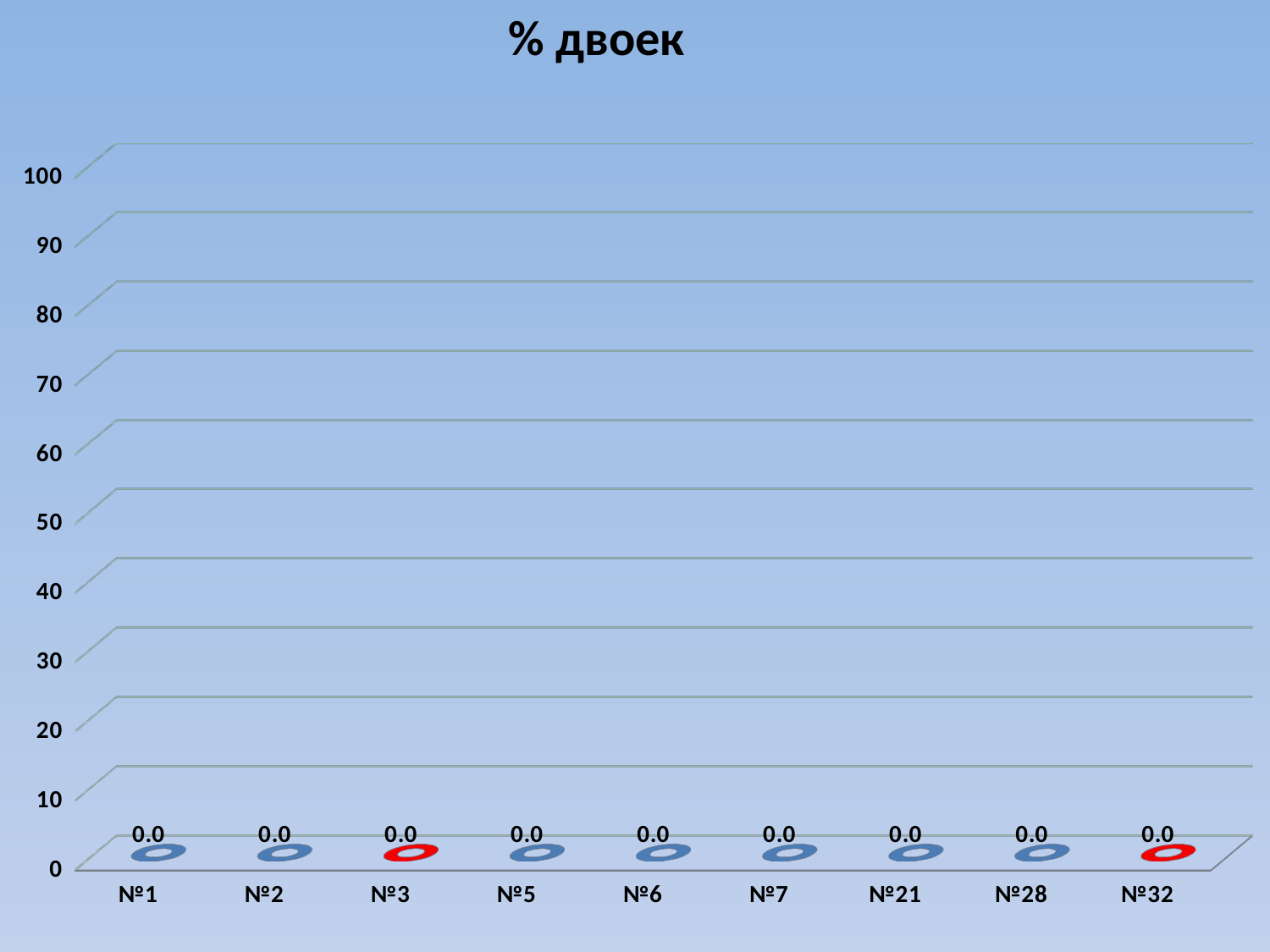
What type of chart is shown on the slide? bar chart Which categories are shown in red rather than blue? №3 and №32 How many categories are shown on the x axis of the chart? 9 What is the value for №32? 0.0 What is the difference between the values for №2 and №28? 0.0 What is the title of the chart? % двоек What is the value for №21? 0.0 Do the values rise, fall, or stay the same across the x axis? stay the same What is the highest value shown on the vertical axis? 100 What is the value for №3? 0.0 What is the value for №1? 0.0 Is the value for №7 greater or less than 10? less